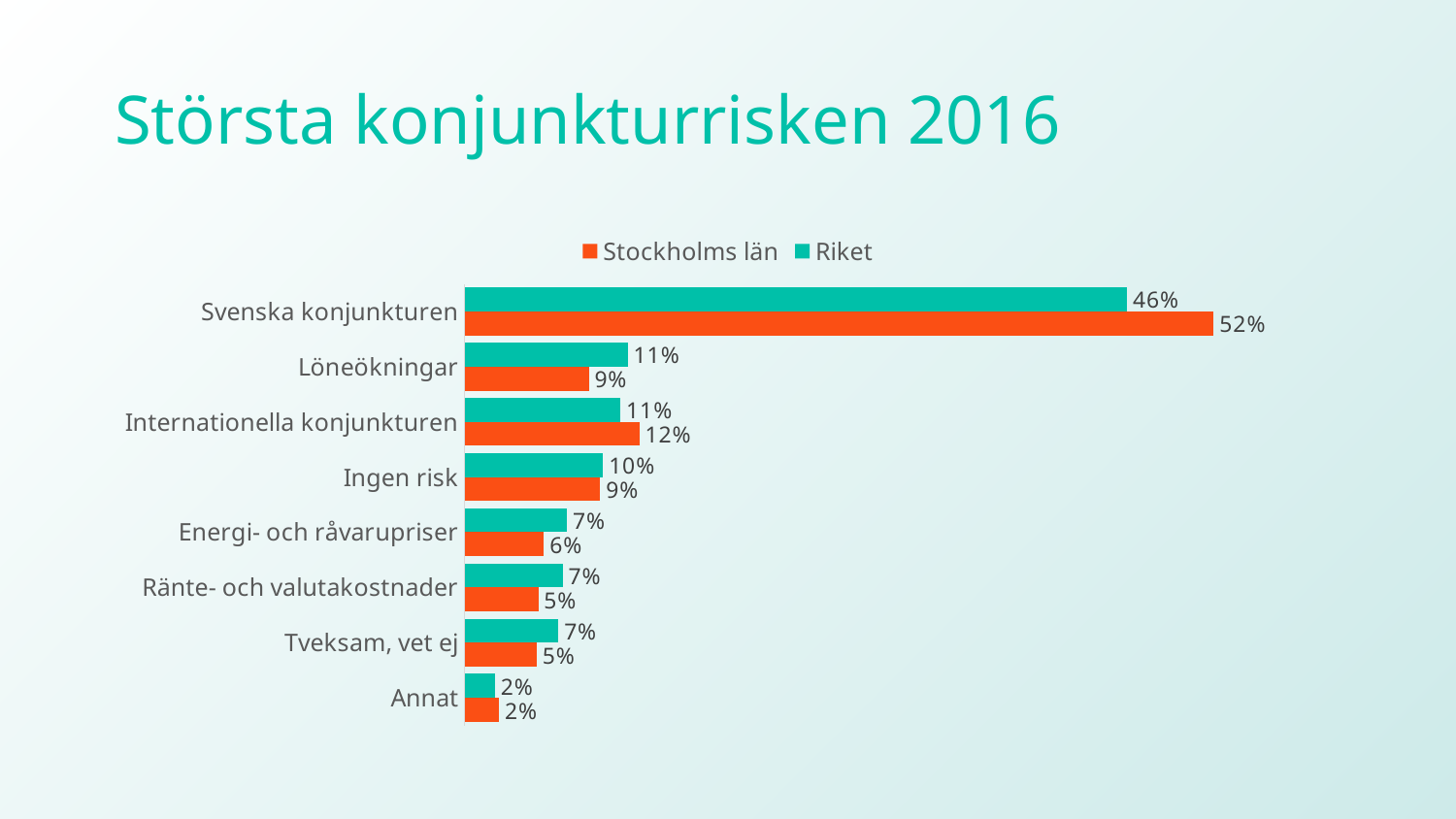
What is the value for Stockholms län for Svenska konjunkturen? 52% For Löneökningar, which series has the larger value, Stockholms län or Riket? Riket Which category has the lowest value for Stockholms län? Annat Which category has the highest value for Riket? Svenska konjunkturen What kind of chart is shown on the slide? Bar chart What is the value for Riket for Löneökningar? 11% How many series does the legend list? 2 What is the value for Stockholms län for Internationella konjunkturen? 12% What is the difference between the Stockholms län and Riket values for Svenska konjunkturen? 6% What is the title of the slide? Största konjunkturrisken 2016 How many categories are shown on the chart? 8 Which colour represents Riket in the chart? Teal